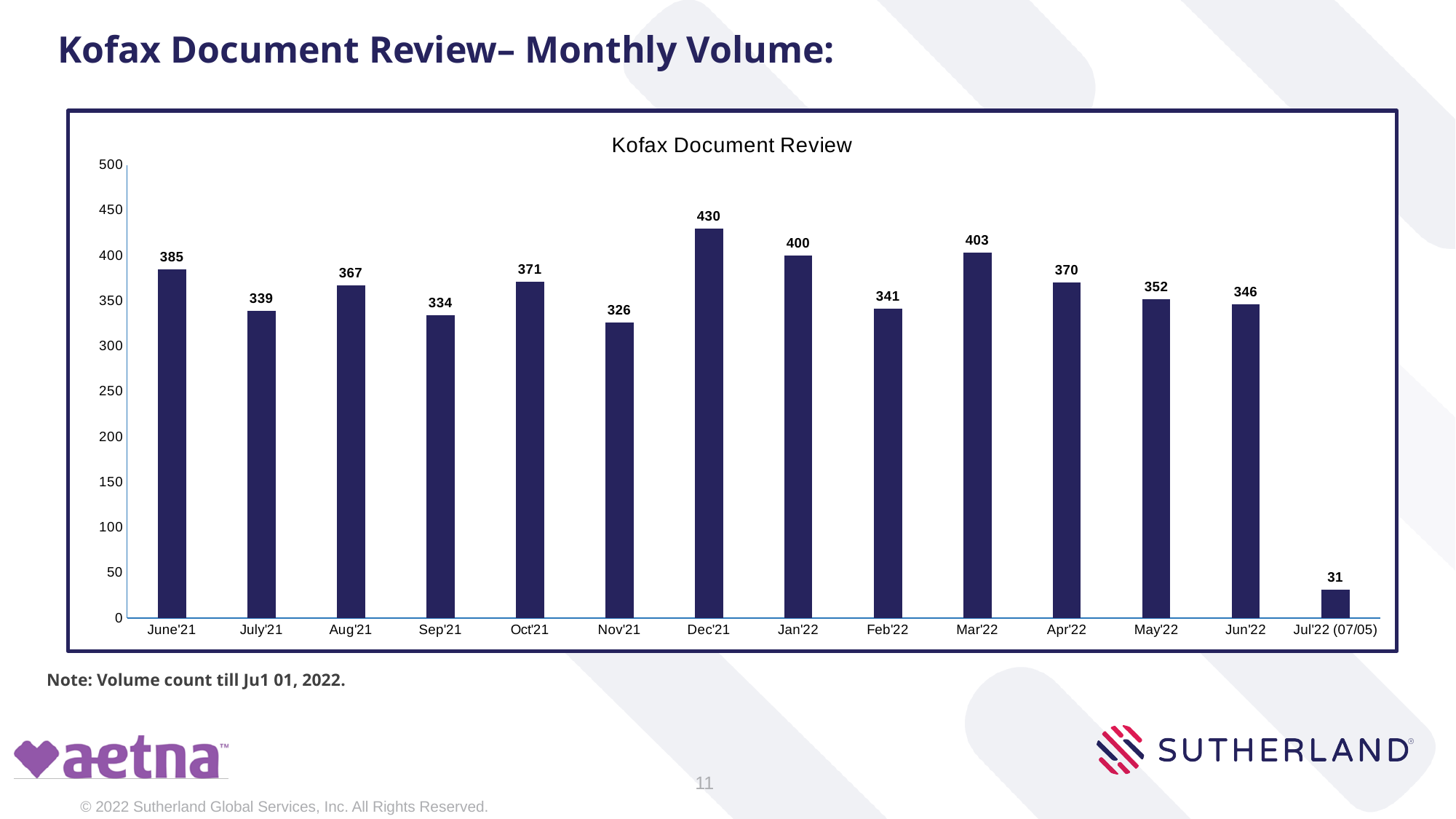
Which month has the lowest value? Jul'22 (07/05) Is the value for Jan'22 greater or less than 350? greater Which is larger, the value for June'21 or the value for Aug'21? June'21 How many months are shown on the x axis? 14 What is the value for Jul'22 (07/05)? 31 What is the difference between the values for Mar'22 and Apr'22? 33 What is the value for Dec'21? 430 Which month has the highest value? Dec'21 What is the title of the chart? Kofax Document Review What kind of chart is shown on the slide? bar chart What is the difference between the values for Dec'21 and Nov'21? 104 What is the value for Sep'21? 334